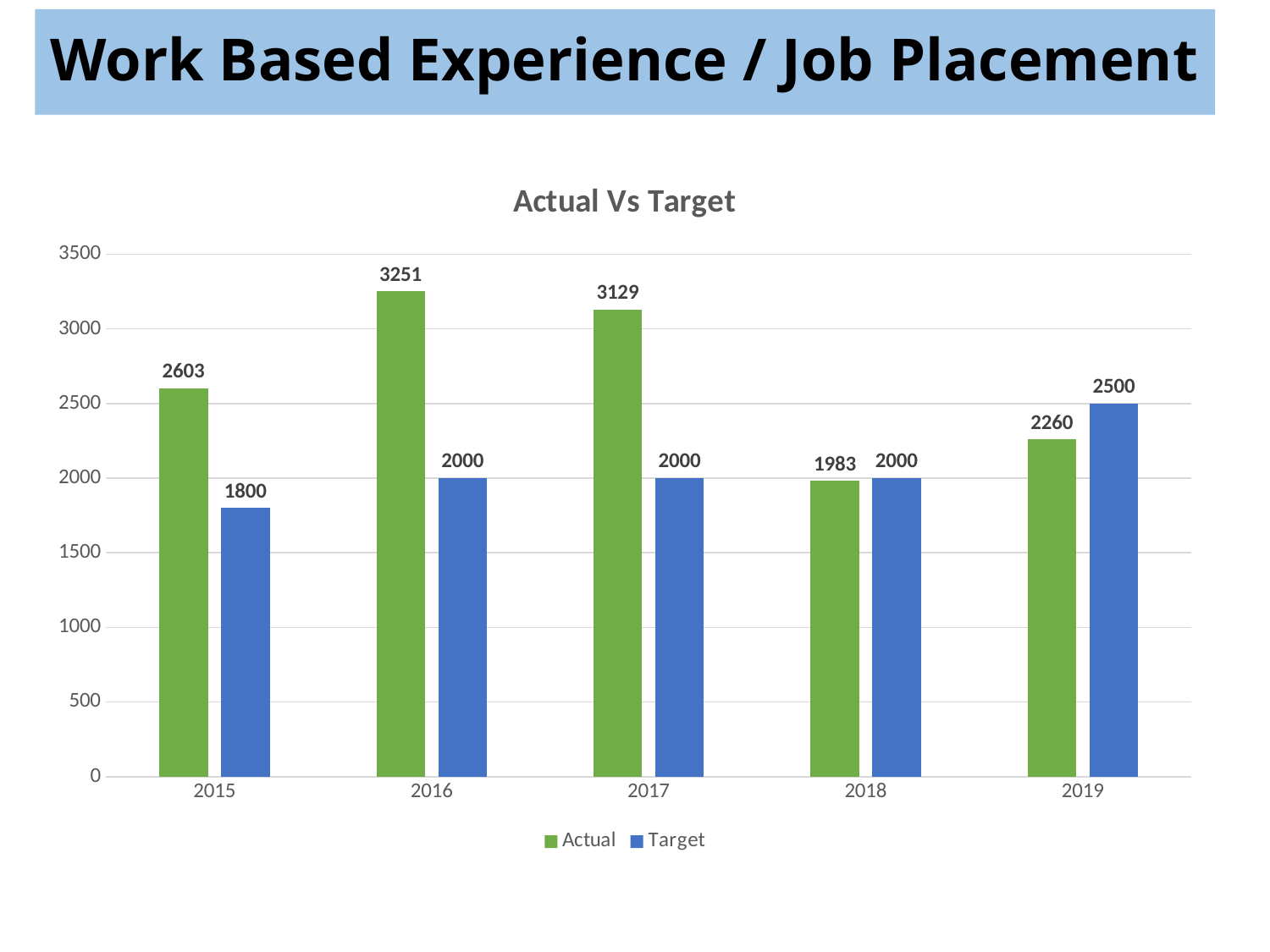
What kind of chart is shown on the slide? bar chart What is the Actual value for 2016? 3251 Which year has the highest Actual value? 2016 How many years are shown on the x axis? 5 Is the Actual value for 2017 greater or less than 3000? greater Which year has the lowest Target value? 2015 What is the title of the chart? Actual Vs Target What is the Actual value for 2018? 1983 What is the Target value for 2019? 2500 What is the difference between the Actual and Target values for 2015? 803 Which is larger for 2018, the Actual value or the Target value? Target How many series does the legend list? 2